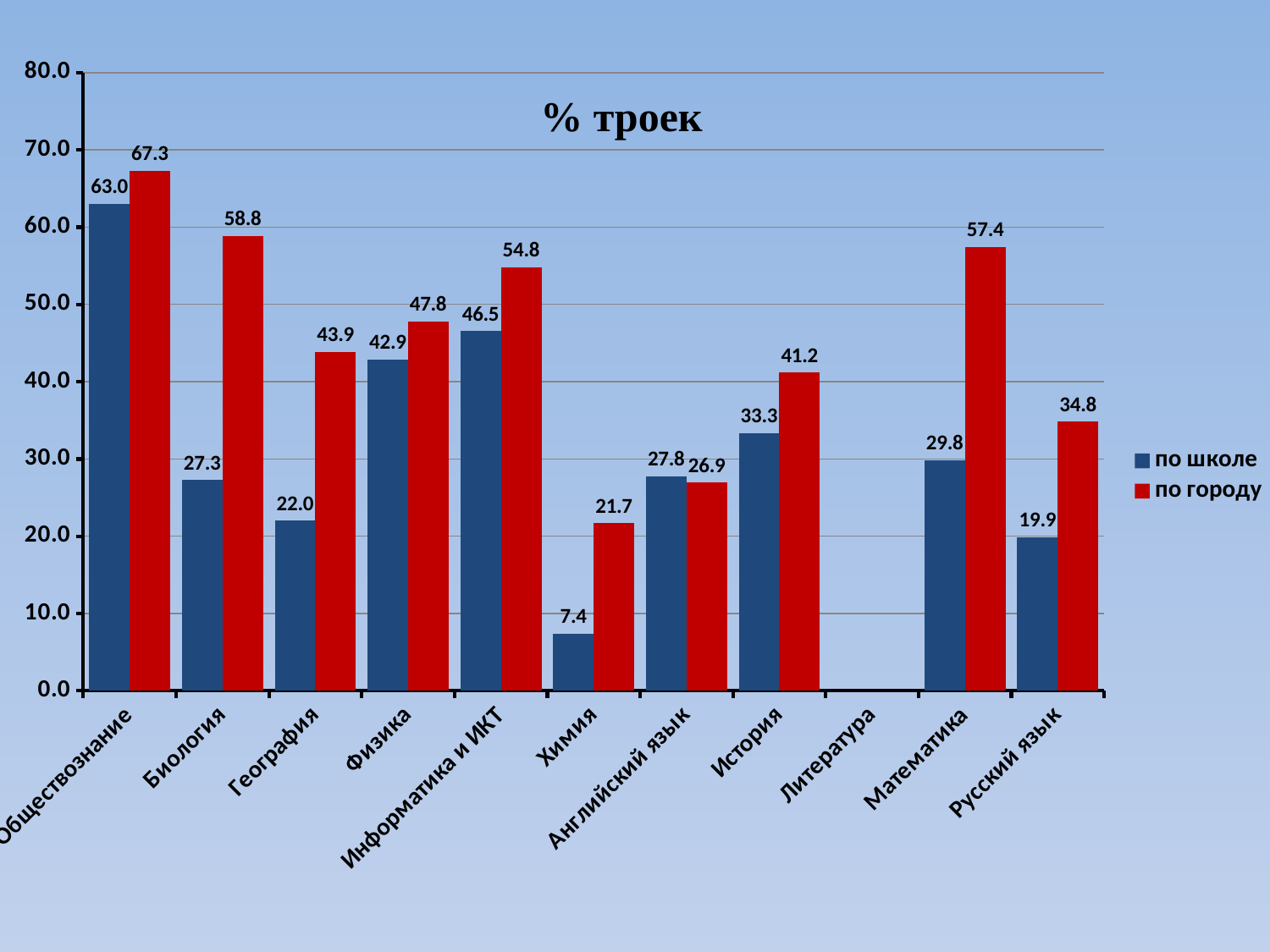
What is the value for "по школе" in Русский язык? 19.9 Which category has the lowest value for "по школе" among those with bars? Химия How many series does the legend list? 2 In Английский язык, which is larger: "по школе" or "по городу"? по школе What is the value for "по городу" in Математика? 57.4 Which category has the highest value for "по городу"? Обществознание How many categories are shown on the x axis? 11 Which category has no bars plotted? Литература What is the value for "по школе" in Химия? 7.4 What type of chart is shown on the slide? bar chart What is the difference between "по городу" and "по школе" in Биология? 31.5 What is the title of the chart? % троек